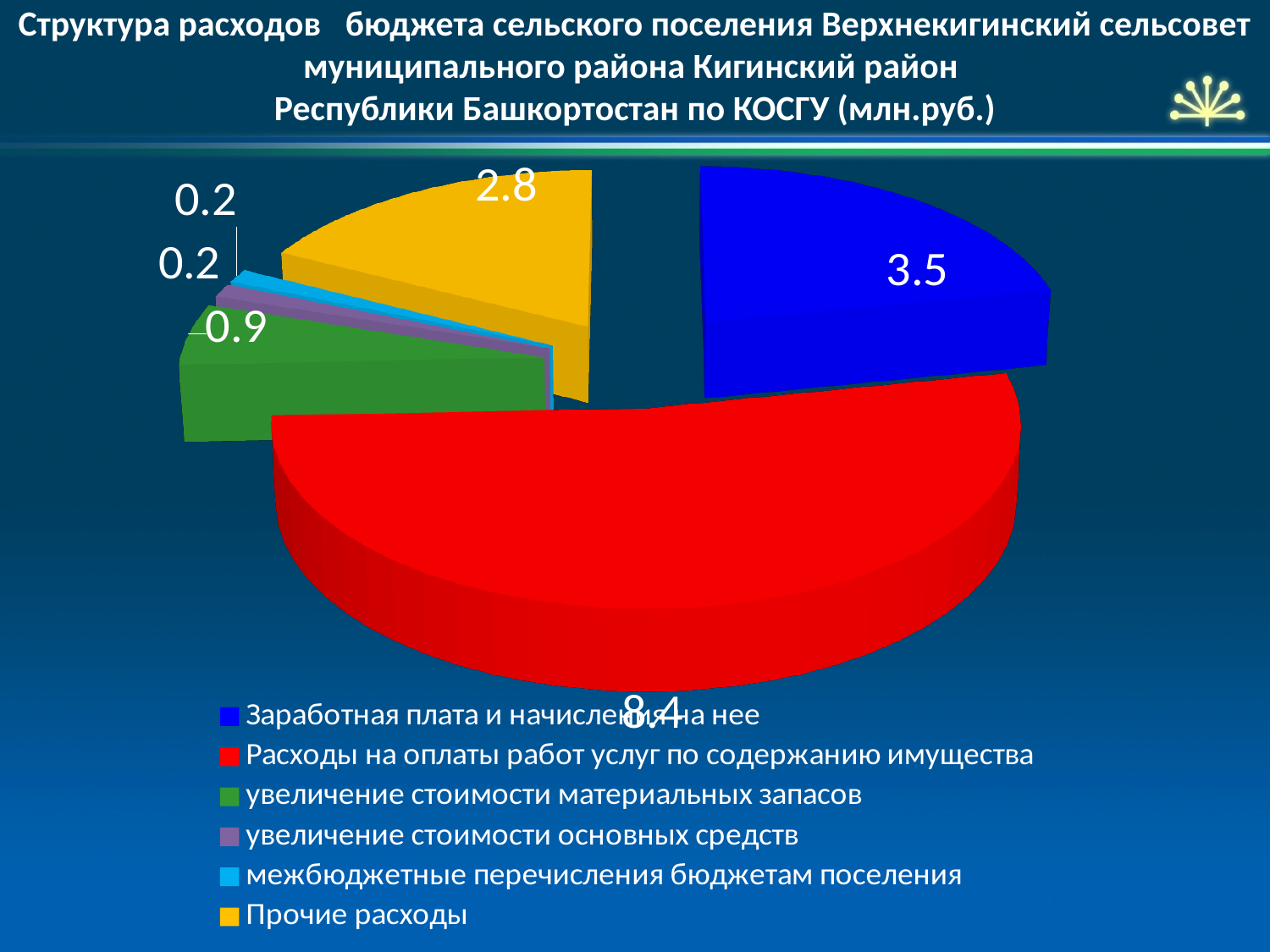
What is the value for "Расходы на оплаты работ услуг по содержанию имущества"? 8.4 What is the value for "Заработная плата и начисления на нее"? 3.5 What colour is the slice for "Заработная плата и начисления на нее"? blue What kind of chart is shown on the slide? pie chart What is the value for "Прочие расходы"? 2.8 Which category has the largest value? Расходы на оплаты работ услуг по содержанию имущества What is the value for "увеличение стоимости материальных запасов"? 0.9 What is the difference between the values for "Расходы на оплаты работ услуг по содержанию имущества" and "Заработная плата и начисления на нее"? 4.9 What is the total of all the slices in the pie chart? 16.0 What is the value for "межбюджетные перечисления бюджетам поселения"? 0.2 How many categories does the legend list? 6 Which is larger: the value for "Прочие расходы" or the value for "увеличение стоимости материальных запасов"? Прочие расходы